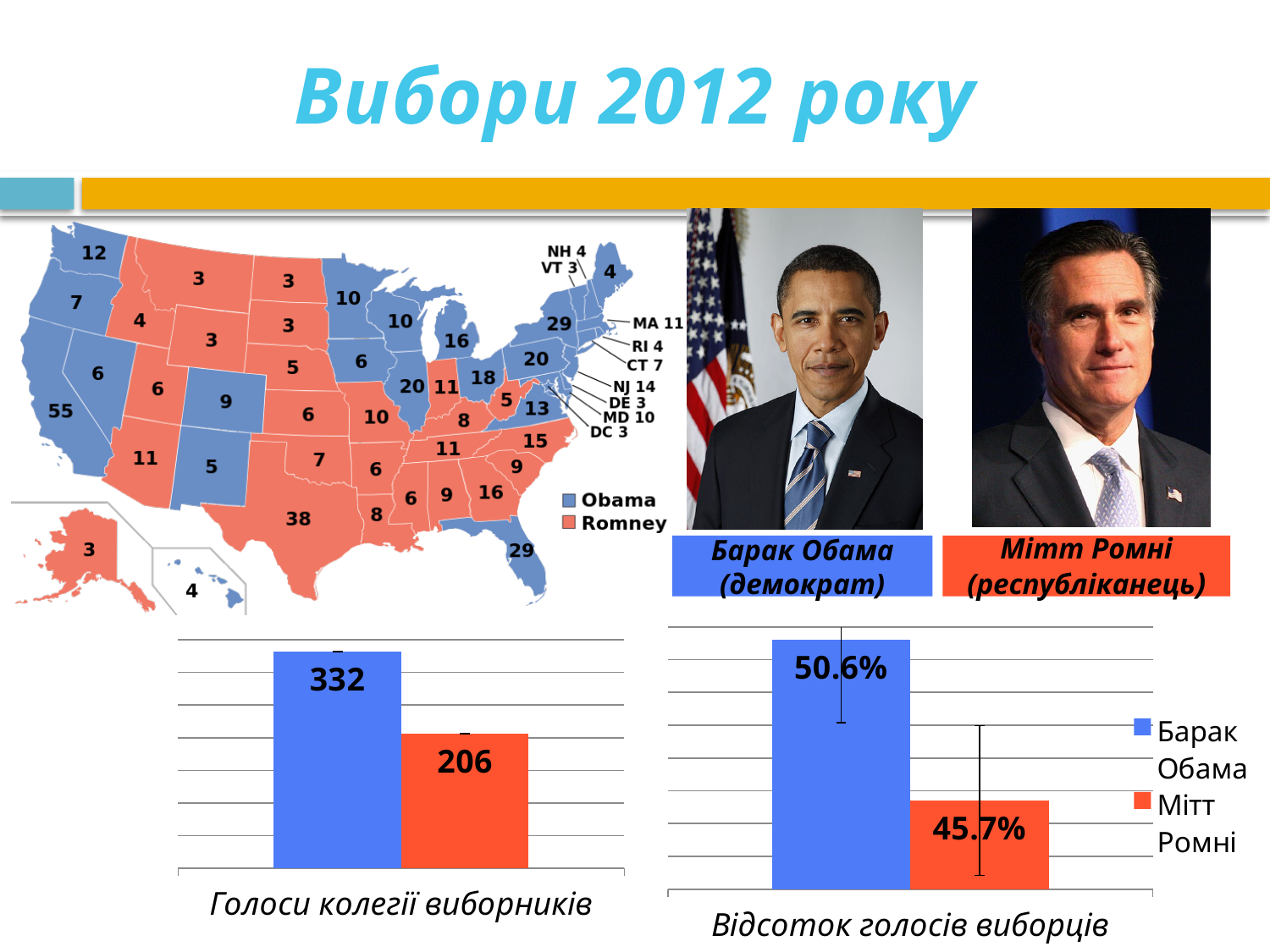
In the chart titled "Голоси колегії виборників", what value is shown for the orange bar (Мітт Ромні)? 206 In the chart titled "Голоси колегії виборників", what is the difference between the two bars? 126 In the chart titled "Відсоток голосів виборців", what are the two legend entries? Барак Обама and Мітт Ромні How many bars are plotted in the chart titled "Голоси колегії виборників"? 2 In the chart titled "Відсоток голосів виборців", what percentage is shown for Барак Обама? 50.6% In the chart titled "Відсоток голосів виборців", what percentage is shown for Мітт Ромні? 45.7% In the chart titled "Відсоток голосів виборців", which candidate has the lower percentage? Мітт Ромні In the chart titled "Відсоток голосів виборців", how many series does the legend list? 2 In the chart titled "Голоси колегії виборників", which bar is higher, the blue one or the orange one? the blue one (Барак Обама) What kind of chart is the one titled "Голоси колегії виборників"? bar chart In the chart titled "Відсоток голосів виборців", what is the difference between the two percentages? 4.9% In the chart titled "Голоси колегії виборників", what value is shown for the blue bar (Барак Обама)? 332